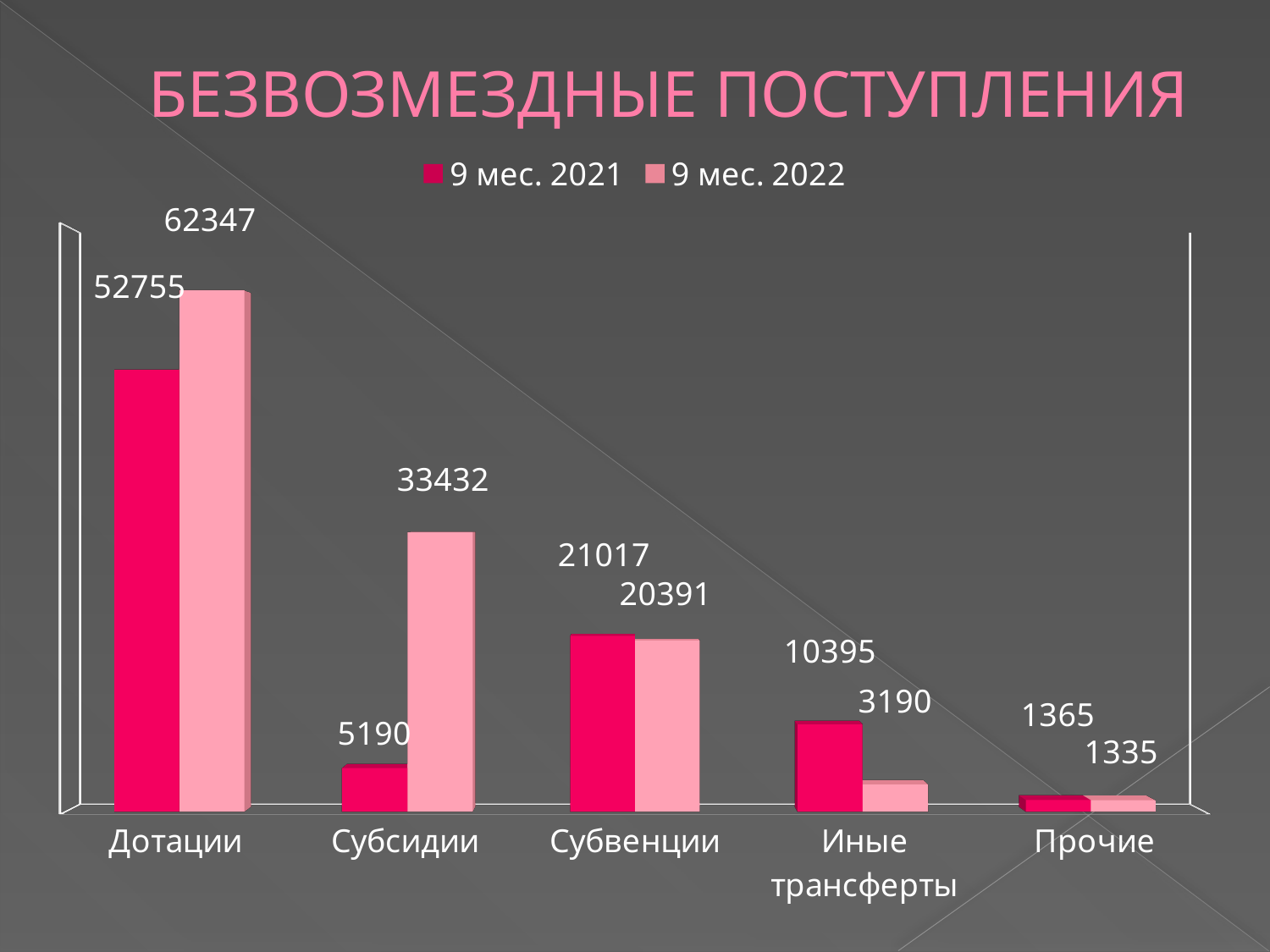
What kind of chart is shown on the slide? bar chart Which category has the highest value in the 9 мес. 2022 series? Дотации What is the value for Дотации in the 9 мес. 2022 series? 62347 Which category has the lowest value in the 9 мес. 2021 series? Прочие What is the value for Субсидии in the 9 мес. 2021 series? 5190 How many series does the legend list? 2 What is the value for Прочие in the 9 мес. 2021 series? 1365 What is the title of the chart? БЕЗВОЗМЕЗДНЫЕ ПОСТУПЛЕНИЯ Which is larger for Иные трансферты: the 9 мес. 2021 value or the 9 мес. 2022 value? 9 мес. 2021 What is the difference between the 9 мес. 2022 and 9 мес. 2021 values for Субсидии? 28242 What is the value for Иные трансферты in the 9 мес. 2022 series? 3190 How many categories are shown on the x axis? 5